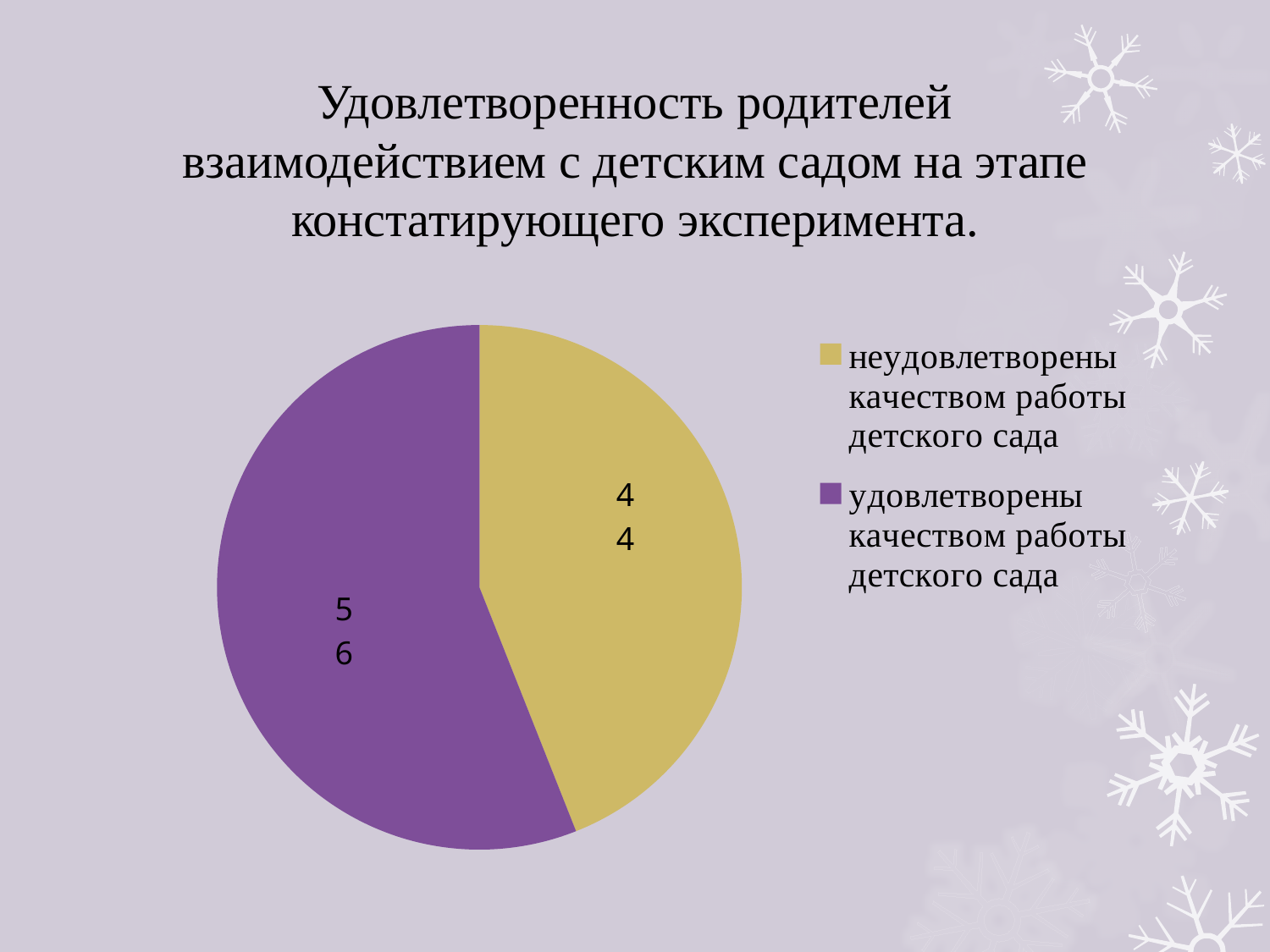
What colour is the slice for 'неудовлетворены качеством работы детского сада'? yellow What is the difference between the values for 'удовлетворены' and 'неудовлетворены' качеством работы детского сада? 12 What is the value shown for the slice 'неудовлетворены качеством работы детского сада'? 44 How many entries does the legend list? 2 Which category has the smallest slice of the pie? неудовлетворены качеством работы детского сада What is the total of the two slice values in the pie chart? 100 What type of chart is shown on the slide? pie chart What is the value shown for the slice 'удовлетворены качеством работы детского сада'? 56 Which is larger: the value for 'удовлетворены качеством работы детского сада' or for 'неудовлетворены качеством работы детского сада'? удовлетворены качеством работы детского сада What share of the pie does the slice 'удовлетворены качеством работы детского сада' represent? 56% Which category has the largest slice of the pie? удовлетворены качеством работы детского сада How many slices does the pie chart have? 2